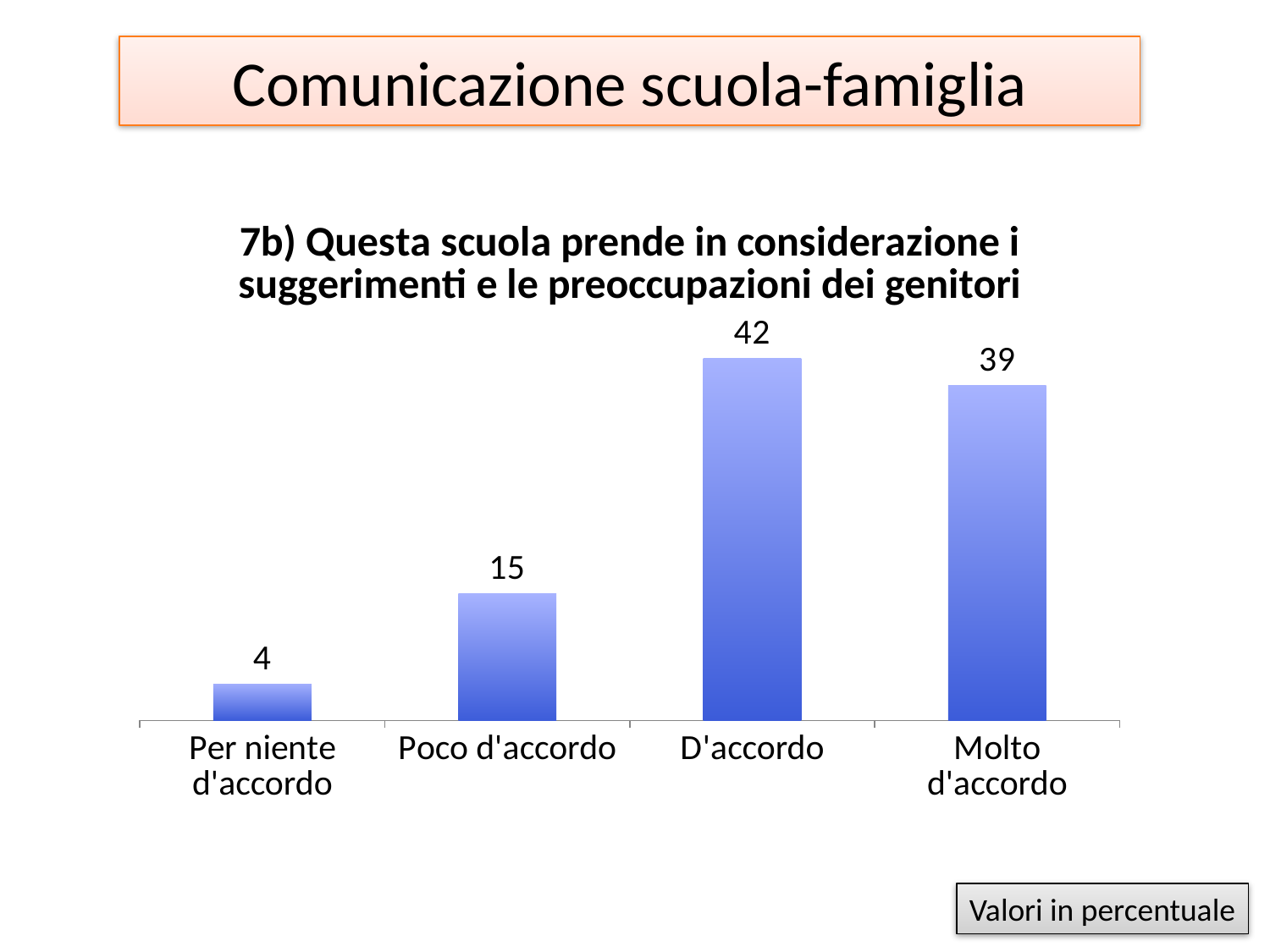
What is the difference between the values for "D'accordo" and "Molto d'accordo"? 3 What kind of chart is shown on the slide? Bar chart What is the value for "D'accordo"? 42 What is the value for "Molto d'accordo"? 39 Which category has the lowest value? Per niente d'accordo What is the title of the chart? 7b) Questa scuola prende in considerazione i suggerimenti e le preoccupazioni dei genitori Which is larger, the value for "Poco d'accordo" or the value for "Molto d'accordo"? Molto d'accordo What is the value for "Poco d'accordo"? 15 How many categories are shown on the x axis? 4 What is the value for "Per niente d'accordo"? 4 Which category has the highest value? D'accordo What is the difference between the values for "Poco d'accordo" and "Per niente d'accordo"? 11